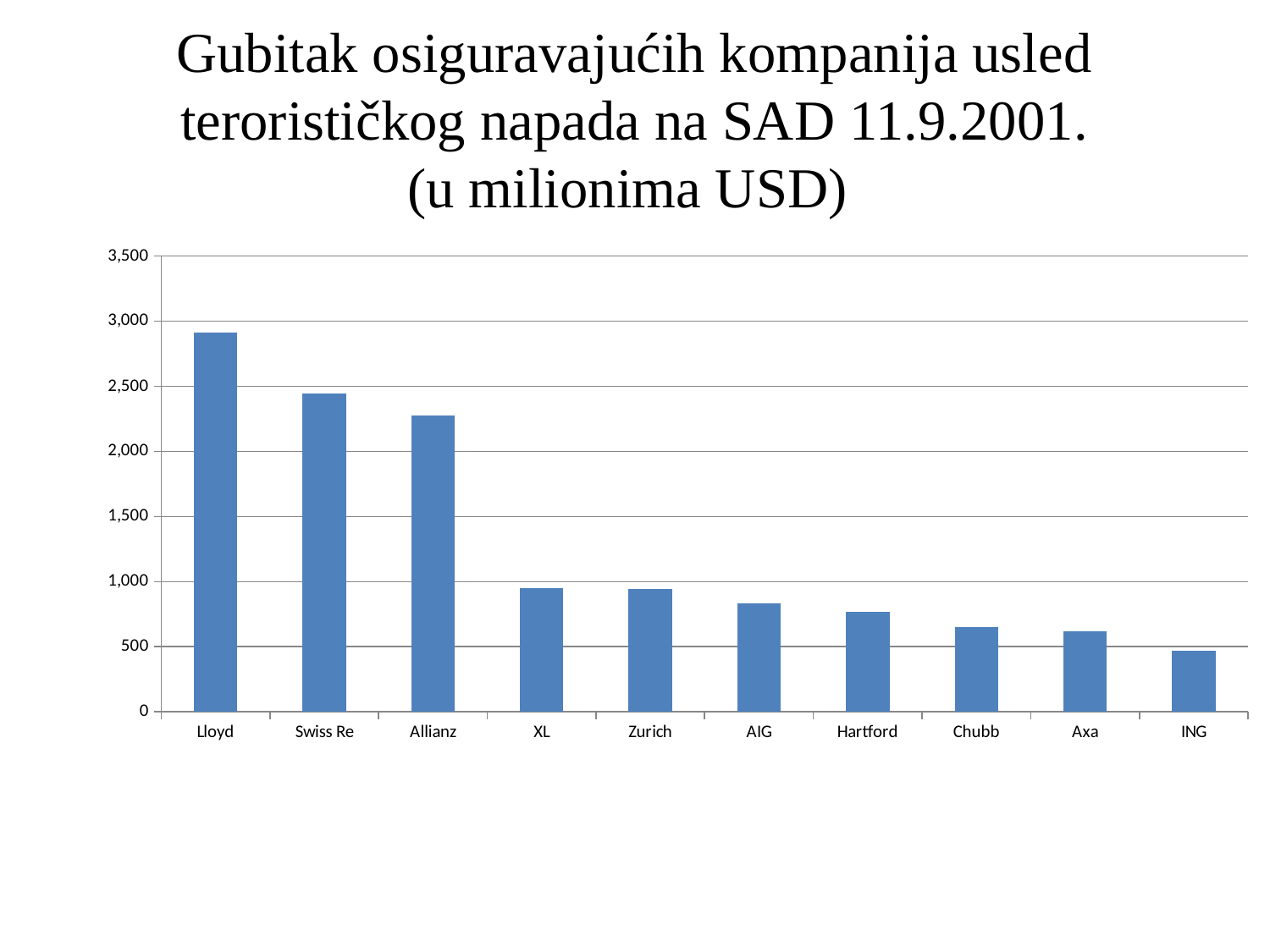
Is the value for XL greater or less than 1,000? less Do the values generally rise or fall from left to right along the x axis? fall Which is larger, the value for AIG or the value for Hartford? AIG Which company has the lowest loss in the chart? ING What kind of chart is shown on the slide? bar chart Which company has the highest loss in the chart? Lloyd Is the value for Swiss Re greater or less than 2,500? less How many companies are shown on the x axis of the chart? 10 Is the value for Lloyd greater or less than 2,500? greater Which is larger, the value for Swiss Re or the value for Allianz? Swiss Re